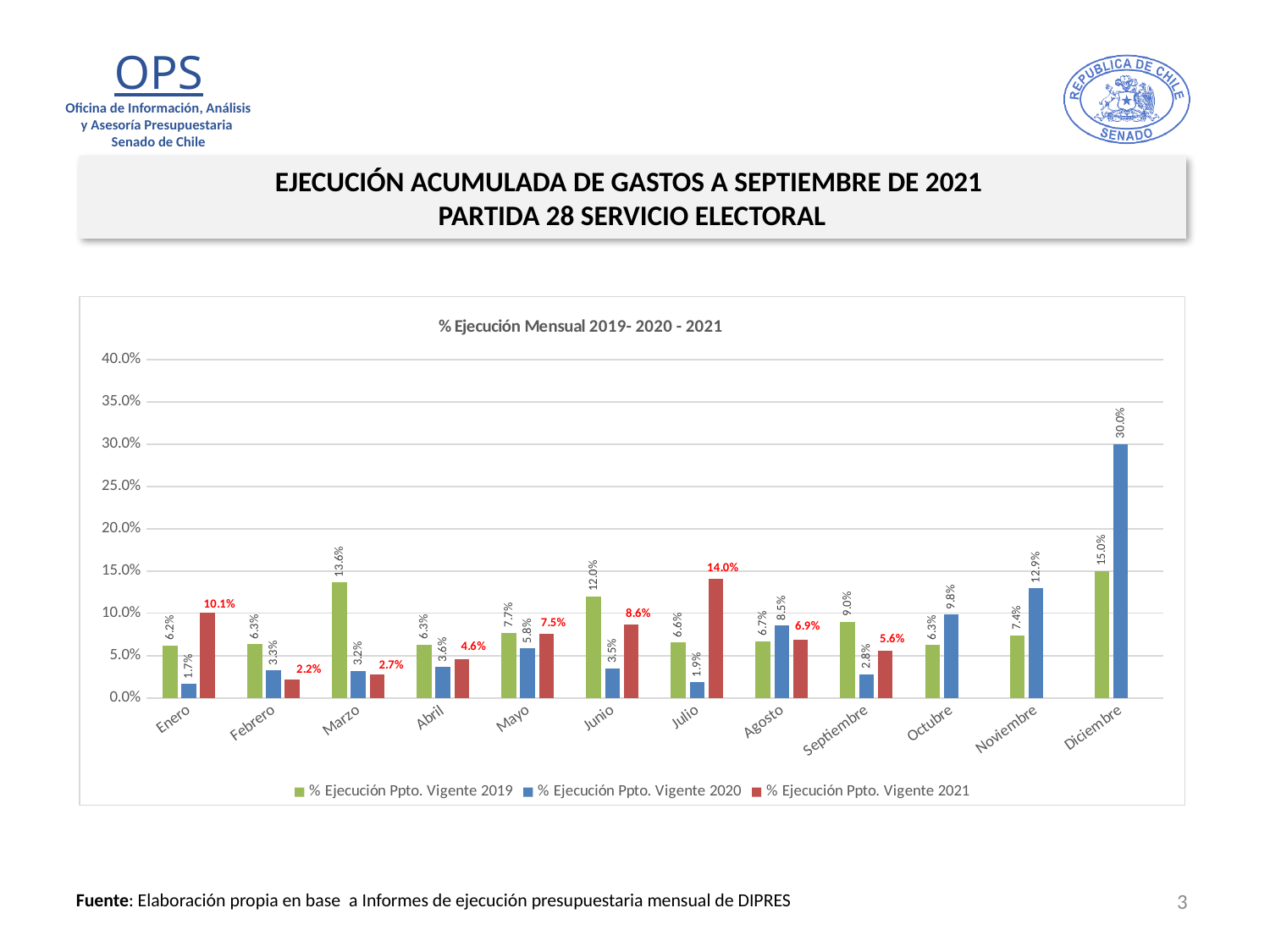
Which month has the lowest value for % Ejecución Ppto. Vigente 2020? Enero What is the value for % Ejecución Ppto. Vigente 2019 in Marzo? 13.6% Is the value for % Ejecución Ppto. Vigente 2020 in Diciembre greater or less than 25.0%? greater Which month has the highest value for % Ejecución Ppto. Vigente 2019? Diciembre What is the difference between the 2020 and 2019 values in Diciembre? 15.0% What kind of chart is shown on the slide? Bar chart Which month has the highest value for % Ejecución Ppto. Vigente 2021? Julio How many months are shown on the x axis? 12 How many series does the legend list? 3 In Agosto, which series has the larger value: % Ejecución Ppto. Vigente 2019 or % Ejecución Ppto. Vigente 2020? % Ejecución Ppto. Vigente 2020 What is the value for % Ejecución Ppto. Vigente 2020 in Diciembre? 30.0% What is the value for % Ejecución Ppto. Vigente 2021 in Julio? 14.0%